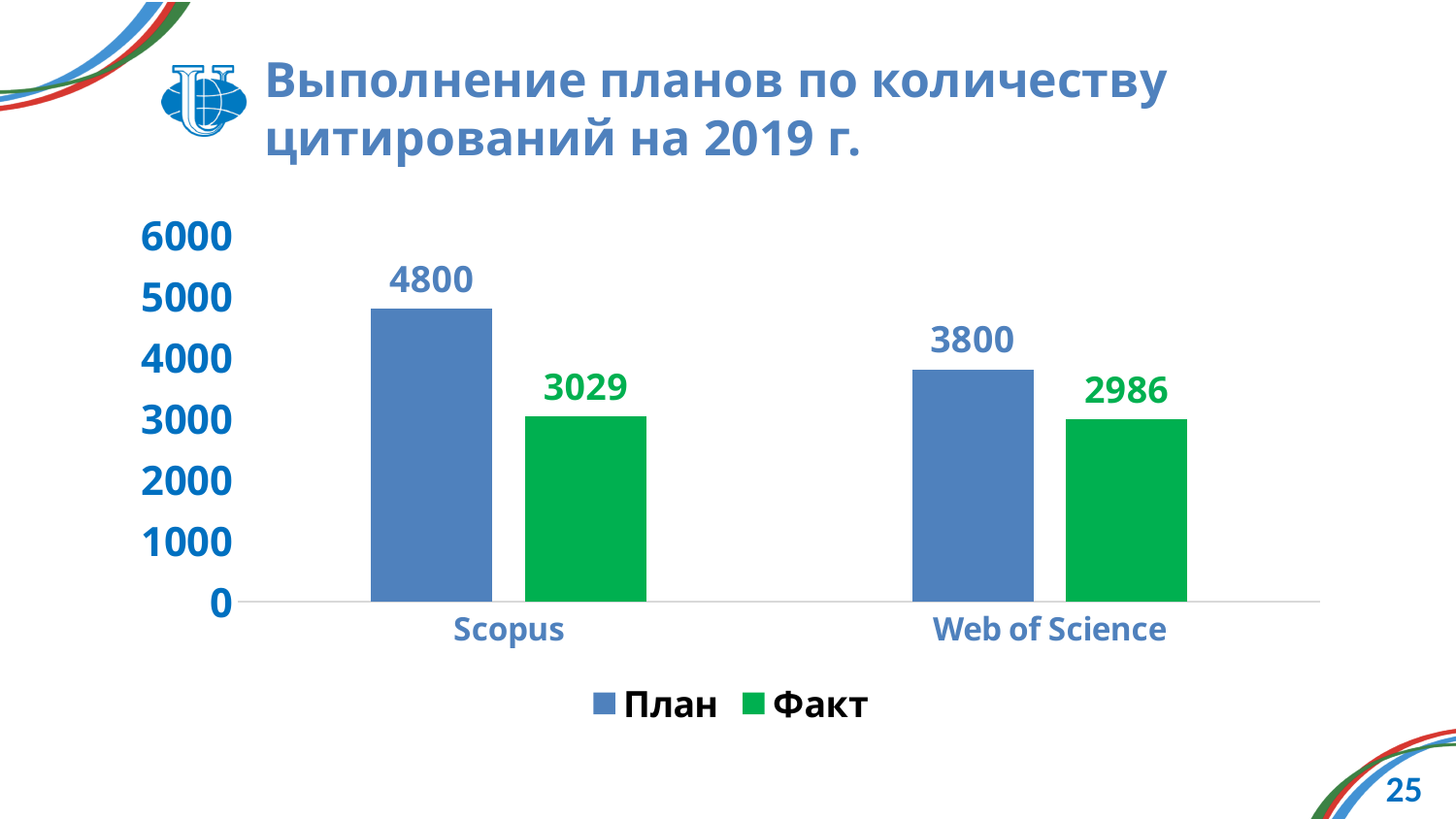
What is the difference between the План and Факт values for Scopus? 1771 Which category has the highest План value? Scopus What kind of chart is shown on the slide? Bar chart What is the План value for Web of Science? 3800 What is the difference between the План and Факт values for Web of Science? 814 What is the Факт value for Scopus? 3029 What is the План (plan) value for Scopus? 4800 What is the Факт (actual) value for Web of Science? 2986 Which category has the lowest Факт value? Web of Science How many categories are shown on the x axis? 2 How many series does the legend list? 2 Which is larger for Web of Science, План or Факт? План